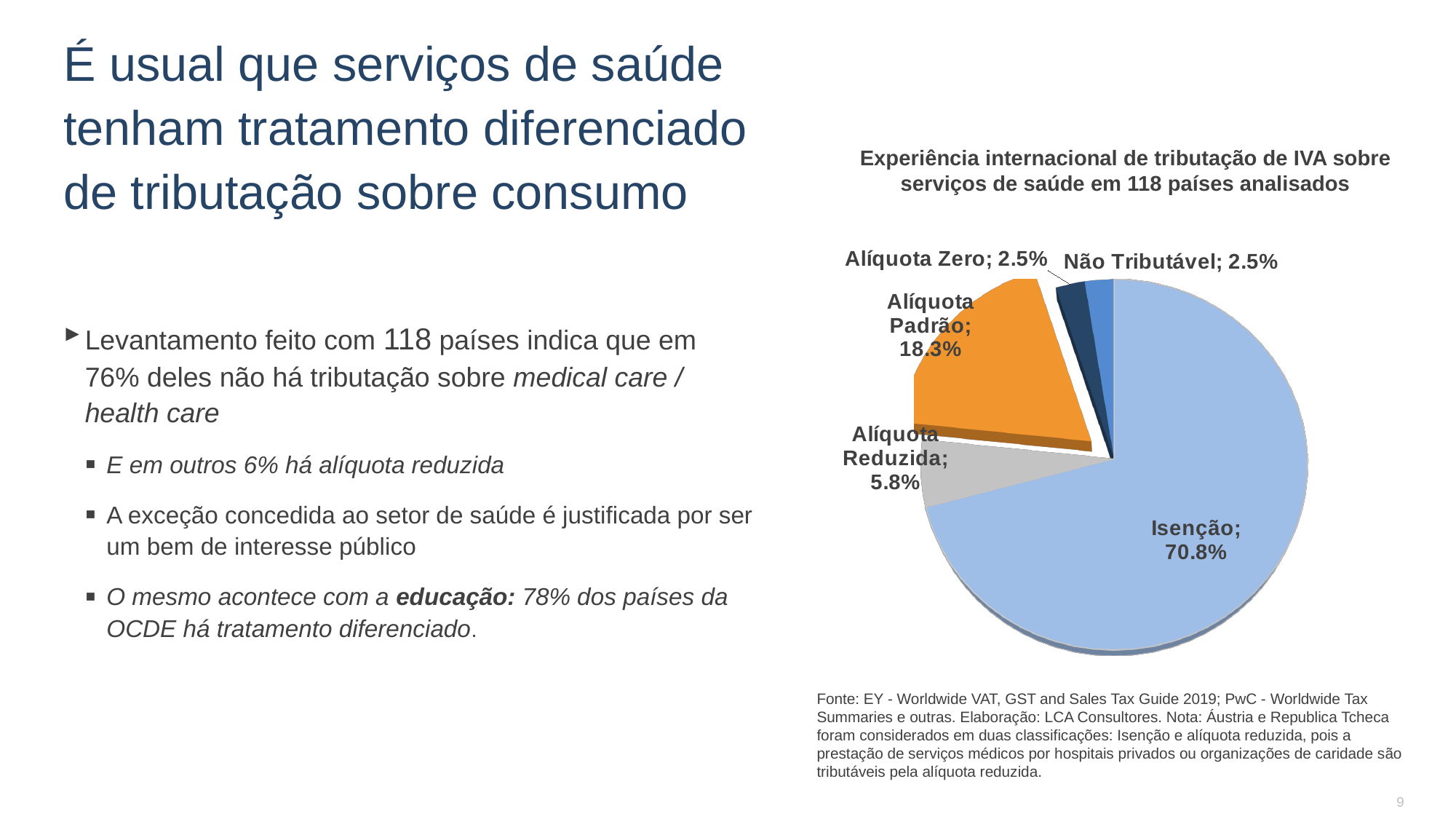
What kind of chart is shown on the slide? Pie chart What is the value shown for Alíquota Reduzida? 5.8% How many slices does the pie chart have? 5 What share of the pie does Isenção represent? 70.8% What is the difference in percentage points between Isenção and Alíquota Padrão? 52.5 percentage points Which is larger, Alíquota Padrão or Alíquota Reduzida? Alíquota Padrão Which category has the largest slice of the pie? Isenção What is the value shown for Não Tributável? 2.5% What is the difference in percentage points between Alíquota Padrão and Alíquota Reduzida? 12.5 percentage points What is the value shown for Alíquota Zero? 2.5% What is the title of the chart? Experiência internacional de tributação de IVA sobre serviços de saúde em 118 países analisados What is the value shown for Alíquota Padrão? 18.3%